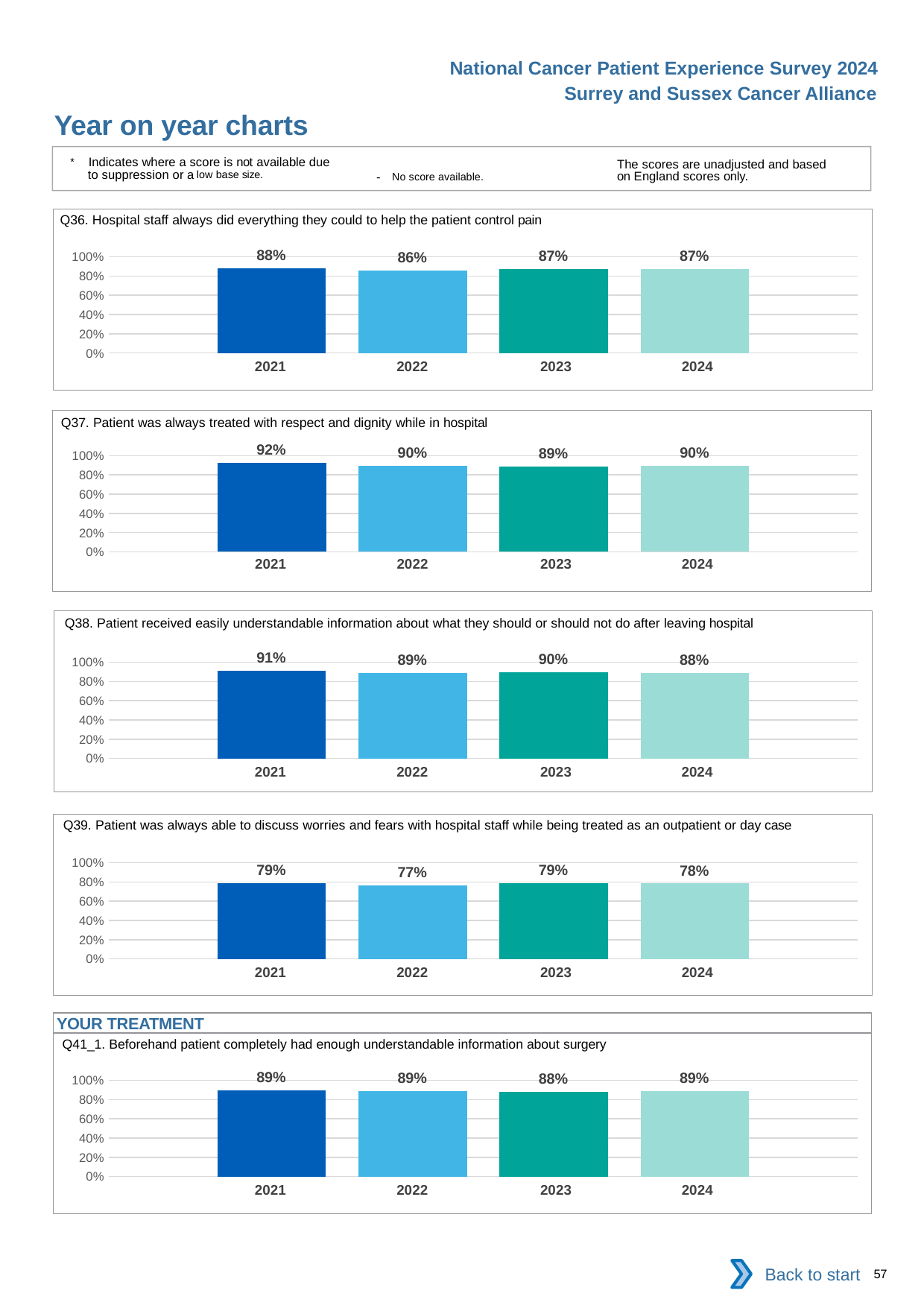
In the Q36 chart, what is the value for 2022? 86% In the Q41_1 chart, which year has the lowest value? 2023 In the Q39 chart, which is larger, the value for 2021 or the value for 2022? 2021 How many years are plotted in the Q36 chart? 4 In the Q38 chart, what is the difference between the 2021 and 2024 values? 3% In the Q39 chart, is the value for 2023 greater or less than 60%? greater In the Q39 chart, what is the value for 2022? 77% In the Q38 chart, what is the difference between the 2022 and 2023 values? 1% What kind of chart is the Q38 chart? bar chart In the Q41_1 chart, what is the value for 2024? 89% In the Q37 chart, which year has the highest value? 2021 In the Q37 chart, which year has the lowest value? 2023